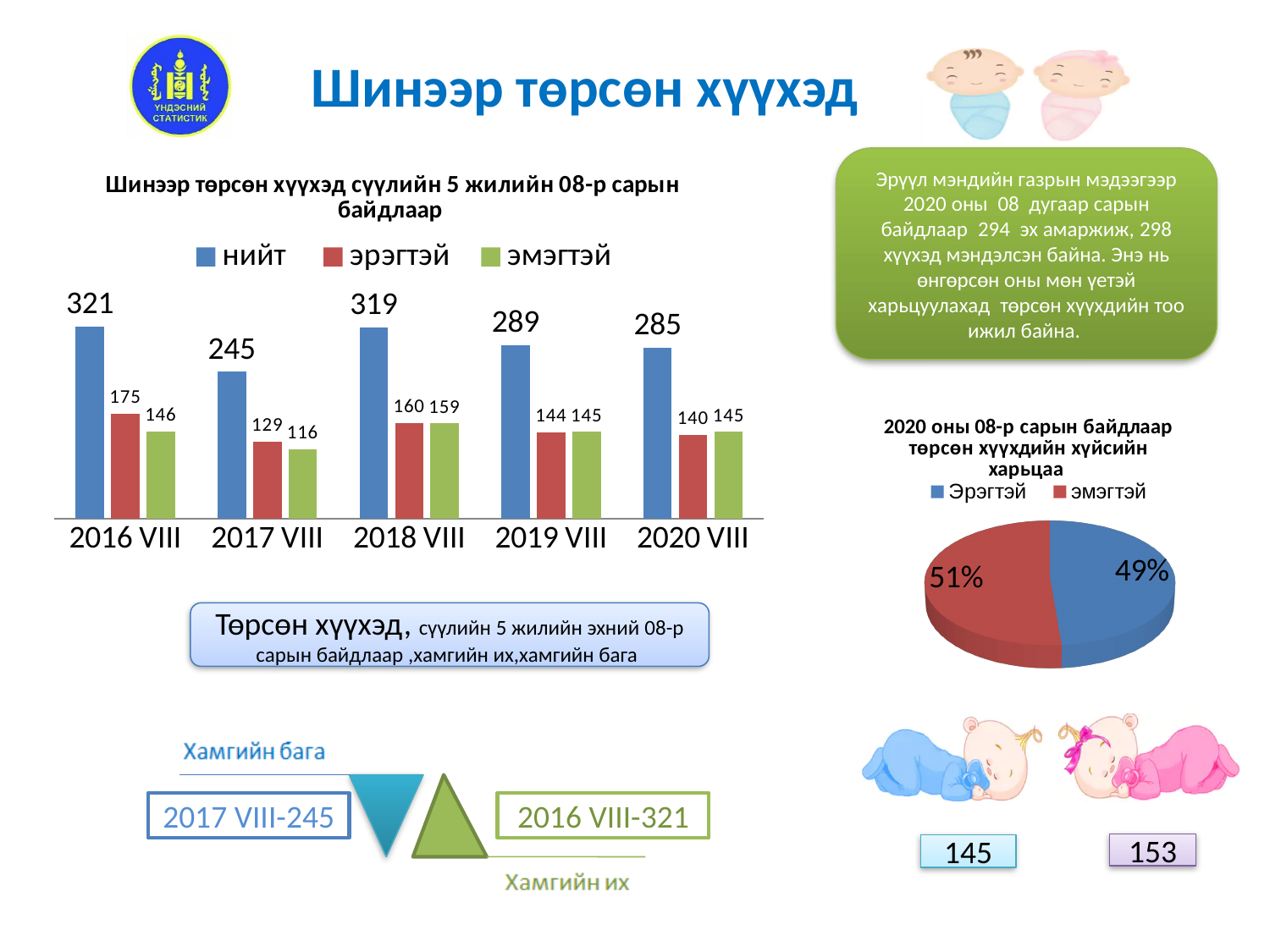
In the bar chart 'Шинээр төрсөн хүүхэд сүүлийн 5 жилийн 08-р сарын байдлаар', which year has the lowest 'эмэгтэй' value? 2017 VIII In the bar chart 'Шинээр төрсөн хүүхэд сүүлийн 5 жилийн 08-р сарын байдлаар', what is the value of 'эмэгтэй' for 2020 VIII? 145 In the bar chart 'Шинээр төрсөн хүүхэд сүүлийн 5 жилийн 08-р сарын байдлаар', what is the difference between the 'нийт' values for 2016 VIII and 2017 VIII? 76 In the bar chart 'Шинээр төрсөн хүүхэд сүүлийн 5 жилийн 08-р сарын байдлаар', which is larger for 2016 VIII: 'эрэгтэй' or 'эмэгтэй'? эрэгтэй In the bar chart 'Шинээр төрсөн хүүхэд сүүлийн 5 жилийн 08-р сарын байдлаар', which year has the highest 'нийт' value? 2016 VIII How many years are shown on the x axis of the bar chart 'Шинээр төрсөн хүүхэд сүүлийн 5 жилийн 08-р сарын байдлаар'? 5 How many series does the legend of the bar chart 'Шинээр төрсөн хүүхэд сүүлийн 5 жилийн 08-р сарын байдлаар' list? 3 In the bar chart 'Шинээр төрсөн хүүхэд сүүлийн 5 жилийн 08-р сарын байдлаар', what is the value of 'нийт' for 2018 VIII? 319 In the pie chart '2020 оны 08-р сарын байдлаар төрсөн хүүхдийн хүйсийн харьцаа', what share does 'эмэгтэй' have? 51% In the pie chart '2020 оны 08-р сарын байдлаар төрсөн хүүхдийн хүйсийн харьцаа', which slice is larger: 'Эрэгтэй' or 'эмэгтэй'? эмэгтэй In the bar chart 'Шинээр төрсөн хүүхэд сүүлийн 5 жилийн 08-р сарын байдлаар', what is the value of 'эрэгтэй' for 2017 VIII? 129 What kind of chart is '2020 оны 08-р сарын байдлаар төрсөн хүүхдийн хүйсийн харьцаа'? pie chart